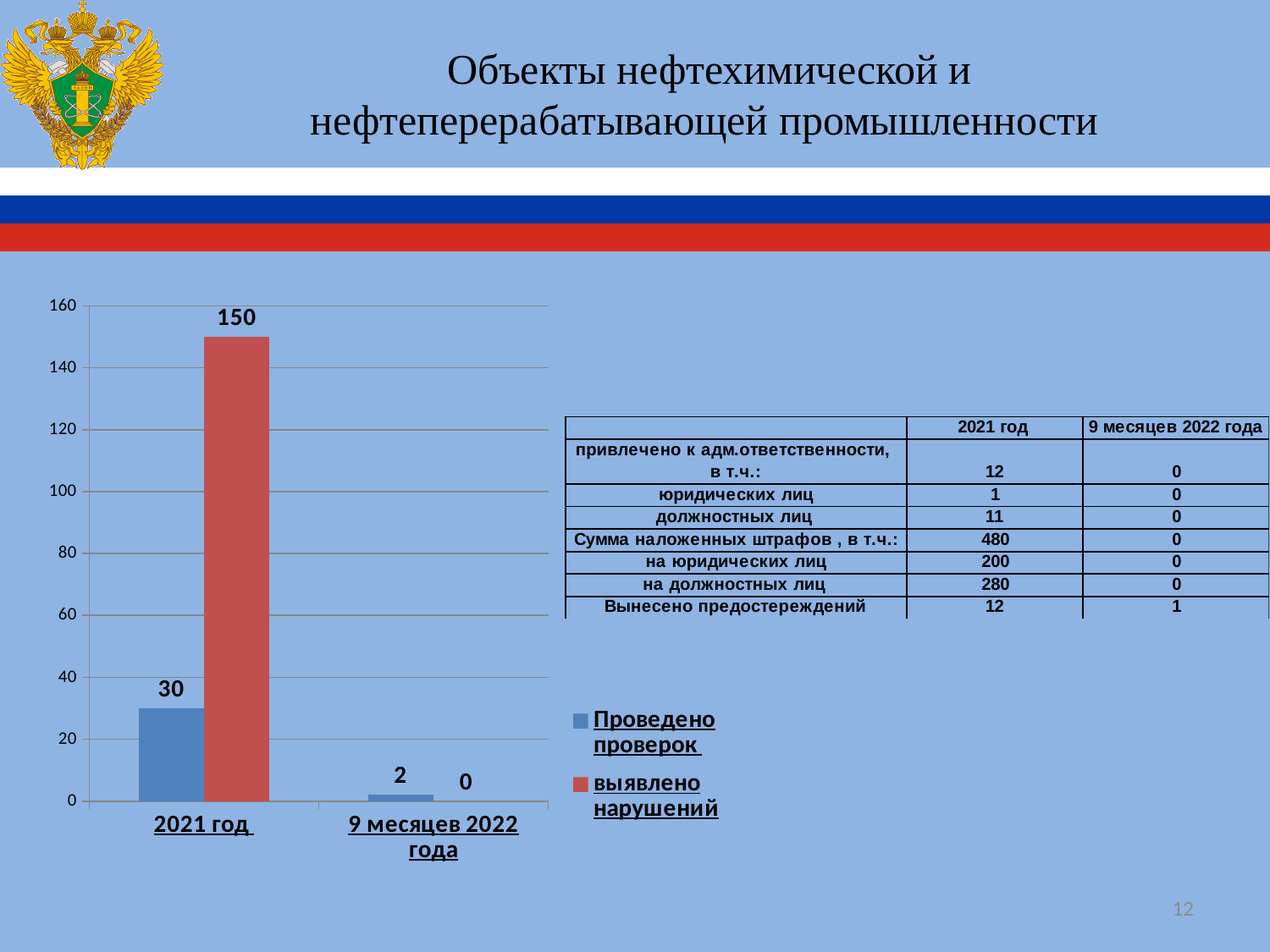
How many categories are shown on the x axis of the chart? 2 Which is larger for 2021 год: "Проведено проверок" or "выявлено нарушений"? выявлено нарушений What is the value of "Проведено проверок" for 9 месяцев 2022 года? 2 What is the value of "выявлено нарушений" for 2021 год? 150 What kind of chart is shown on the slide? bar chart What is the value of "Проведено проверок" for 2021 год? 30 What is the difference between "выявлено нарушений" and "Проведено проверок" for 2021 год? 120 Which category has the highest value for "выявлено нарушений"? 2021 год How many series does the chart legend list? 2 What is the difference in "Проведено проверок" between 2021 год and 9 месяцев 2022 года? 28 Which category has the lowest value for "Проведено проверок"? 9 месяцев 2022 года What is the value of "выявлено нарушений" for 9 месяцев 2022 года? 0